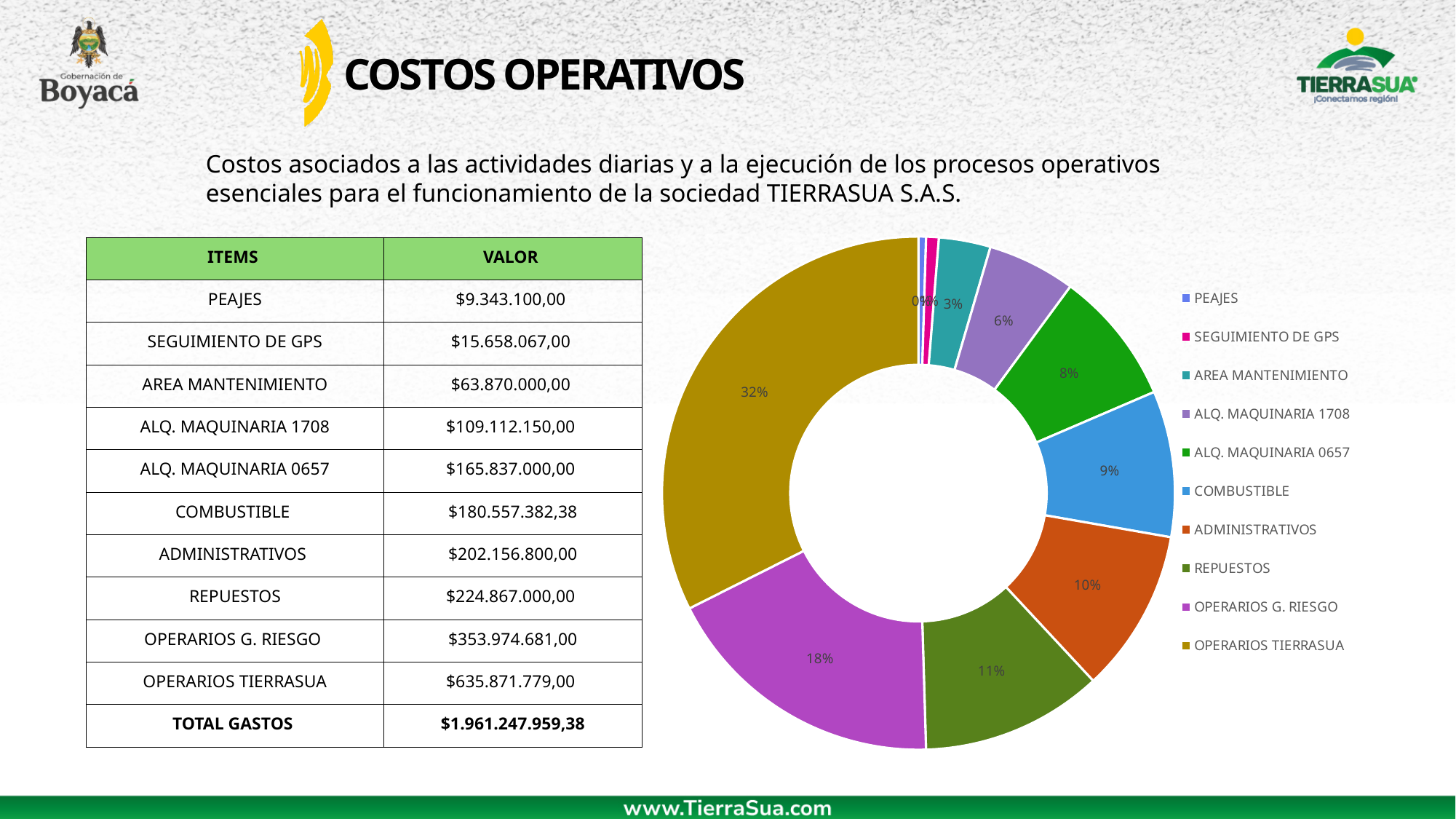
What share of the chart does OPERARIOS TIERRASUA represent? 32% Which category has the largest slice in the chart? OPERARIOS TIERRASUA Which slice is larger, ADMINISTRATIVOS or ALQ. MAQUINARIA 0657? ADMINISTRATIVOS What kind of chart is shown on the slide? doughnut (pie) chart Which category has the smallest slice in the chart? PEAJES Which category is listed first in the chart legend? PEAJES What share of the chart does OPERARIOS G. RIESGO represent? 18% By how many percentage points does the OPERARIOS TIERRASUA share exceed the OPERARIOS G. RIESGO share? 14 percentage points What percentage is shown for ALQ. MAQUINARIA 1708 in the chart? 6% What percentage is shown for COMBUSTIBLE in the chart? 9% How many categories does the chart legend list? 10 What percentage is shown for REPUESTOS in the chart? 11%